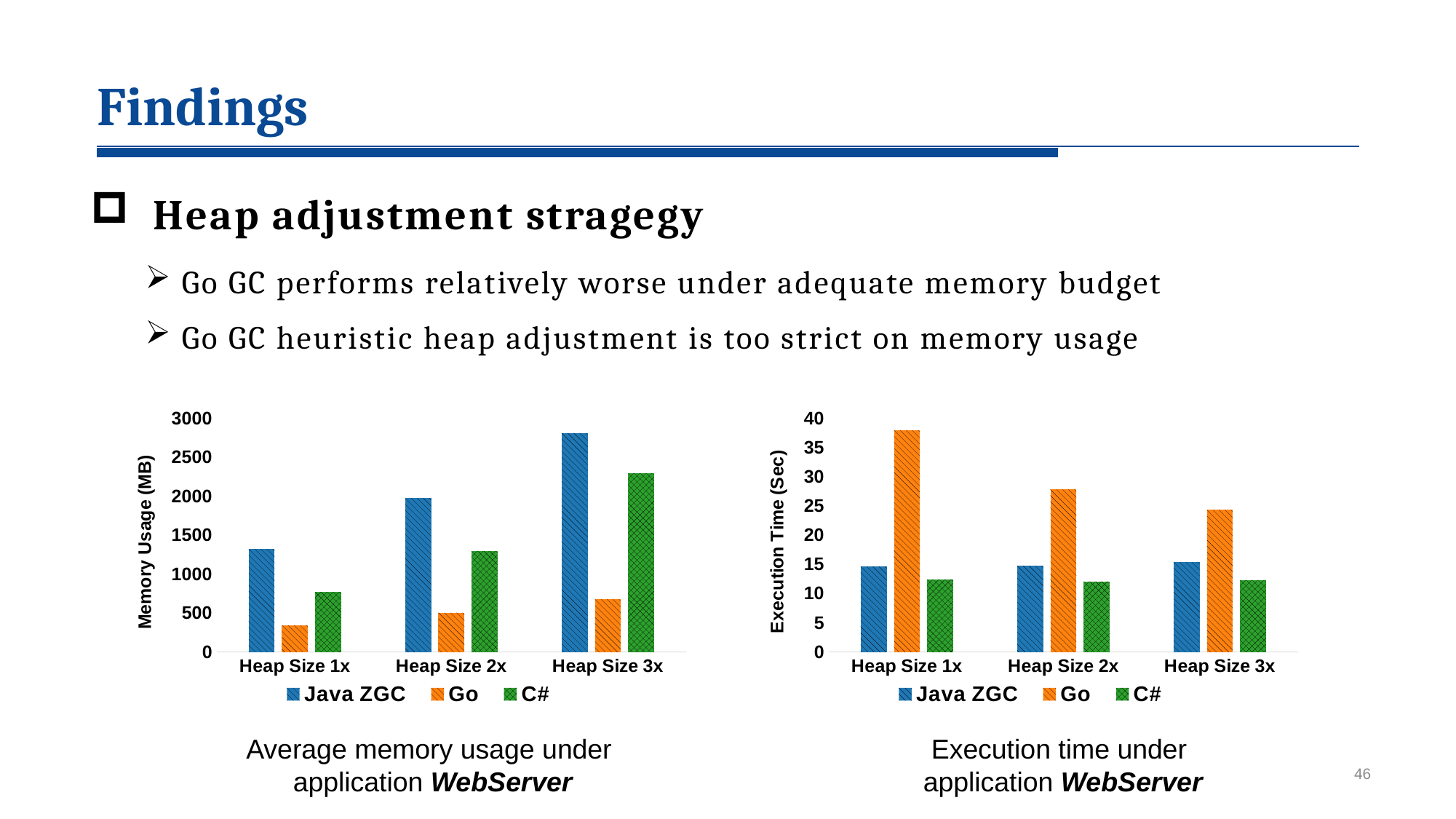
In the right chart (Execution time under application WebServer), does the Go execution time rise or fall as heap size increases from 1x to 3x? fall In the right chart (Execution time under application WebServer), is the Go value at Heap Size 1x greater or less than 35? greater In the left chart (Average memory usage under application WebServer), which series has the highest memory usage at Heap Size 3x? Java ZGC In the left chart (Average memory usage under application WebServer), how many series does the legend list? 3 In the left chart (Average memory usage under application WebServer), does the Java ZGC memory usage rise or fall as heap size increases from 1x to 3x? rise In the left chart (Average memory usage under application WebServer), which series has the lowest memory usage at Heap Size 1x? Go In the right chart (Execution time under application WebServer), how many heap size categories are shown on the x axis? 3 In the right chart (Execution time under application WebServer), what is the label of the y axis? Execution Time (Sec) In the right chart (Execution time under application WebServer), which series has the highest execution time at Heap Size 1x? Go In the left chart (Average memory usage under application WebServer), is the Go value at Heap Size 2x greater or less than 1000? less In the left chart (Average memory usage under application WebServer), is the Java ZGC value at Heap Size 3x greater or less than 2500? greater In the left chart (Average memory usage under application WebServer), what kind of chart is shown? bar chart